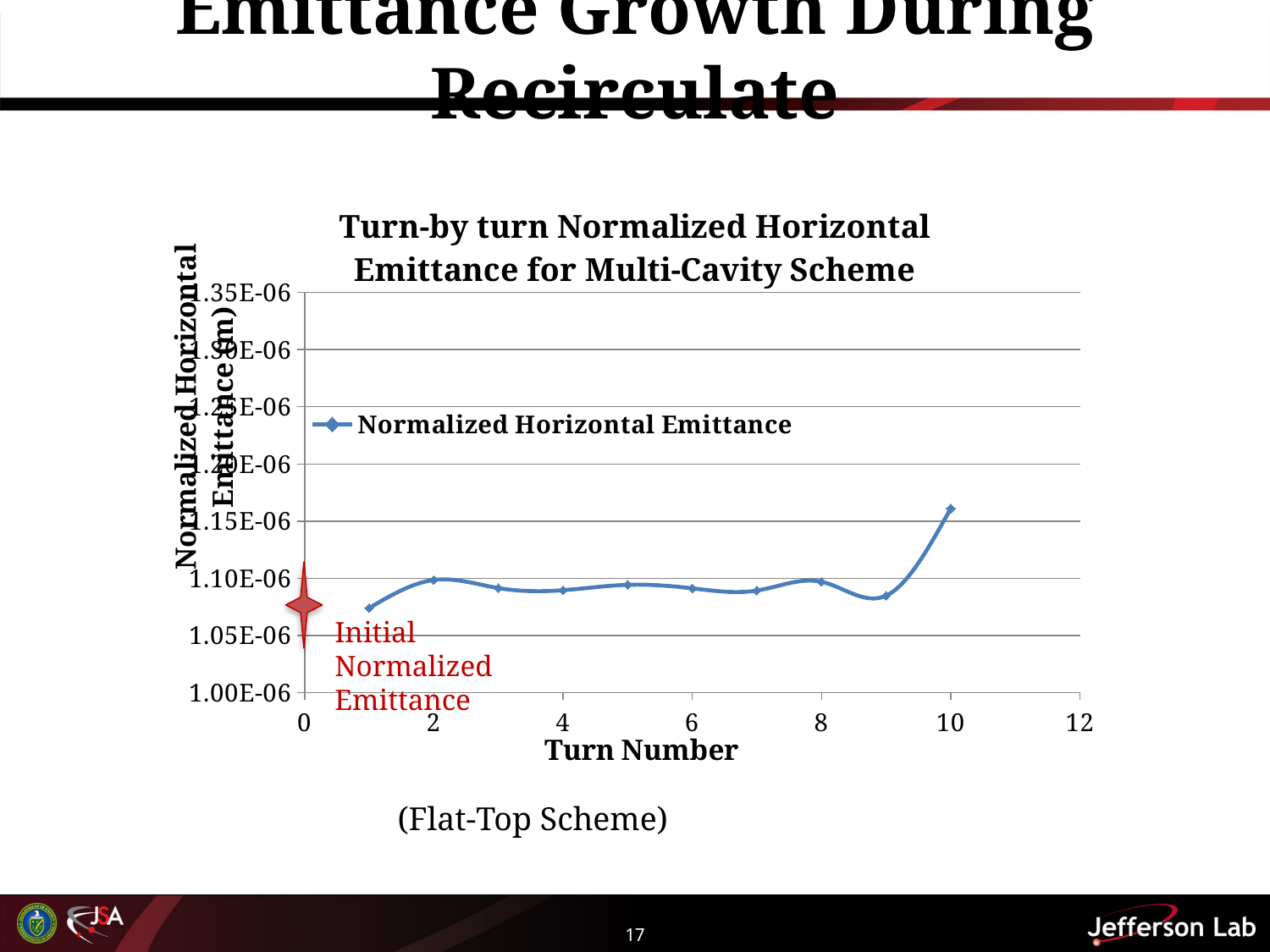
How many data points are plotted on the line? 10 Is the value at turn 10 greater or less than 1.15E-06? greater Is the value at turn 9 greater or less than 1.10E-06? less Which has the larger normalized horizontal emittance, turn 1 or turn 10? turn 10 How many series does the legend list? 1 Does the normalized horizontal emittance rise or fall between turn 9 and turn 10? rise What is the title of the chart? Turn-by turn Normalized Horizontal Emittance for Multi-Cavity Scheme At which turn number is the normalized horizontal emittance lowest? 1 Is the value at turn 1 greater or less than 1.05E-06? greater At which turn number is the normalized horizontal emittance highest? 10 What kind of chart is shown on the slide? line chart What is the name of the series shown in the legend? Normalized Horizontal Emittance